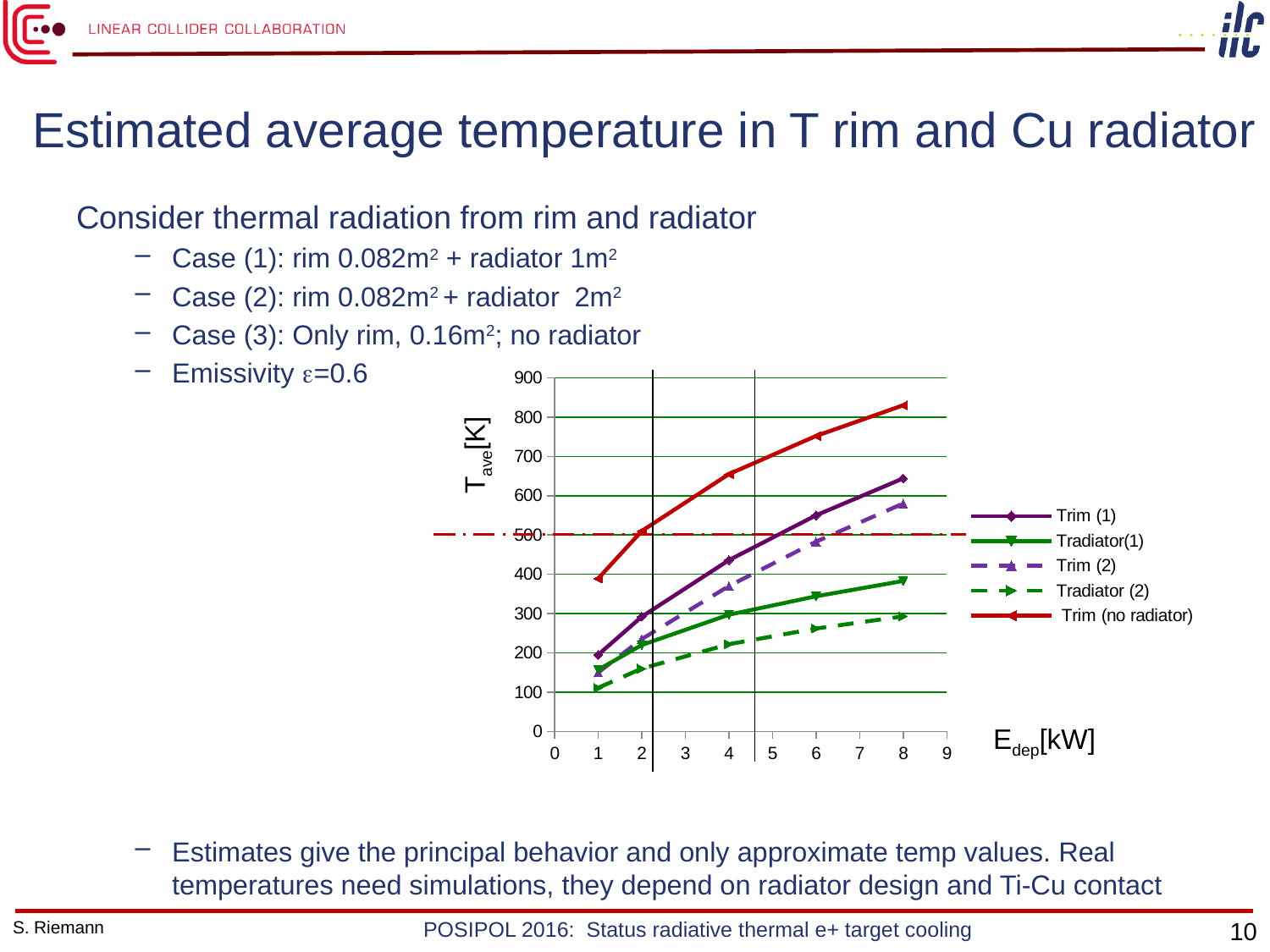
Which series has the lowest temperature at 8 kW? Tradiator (2) Is the value for Trim (2) at 8 kW greater or less than 600? less Do the temperature values rise or fall as E_dep increases along the x axis? rise What kind of chart is shown on the slide? line chart Is the value for Trim (no radiator) at 8 kW greater or less than 800? greater How many data points are plotted for the Trim (no radiator) series? 5 Which series has the highest temperature at 8 kW? Trim (no radiator) Is the value for Tradiator(1) at 8 kW greater or less than 400? less At 8 kW, which is larger: Trim (1) or Trim (2)? Trim (1) What is the label of the y axis? Tave[K] How many series does the legend list? 5